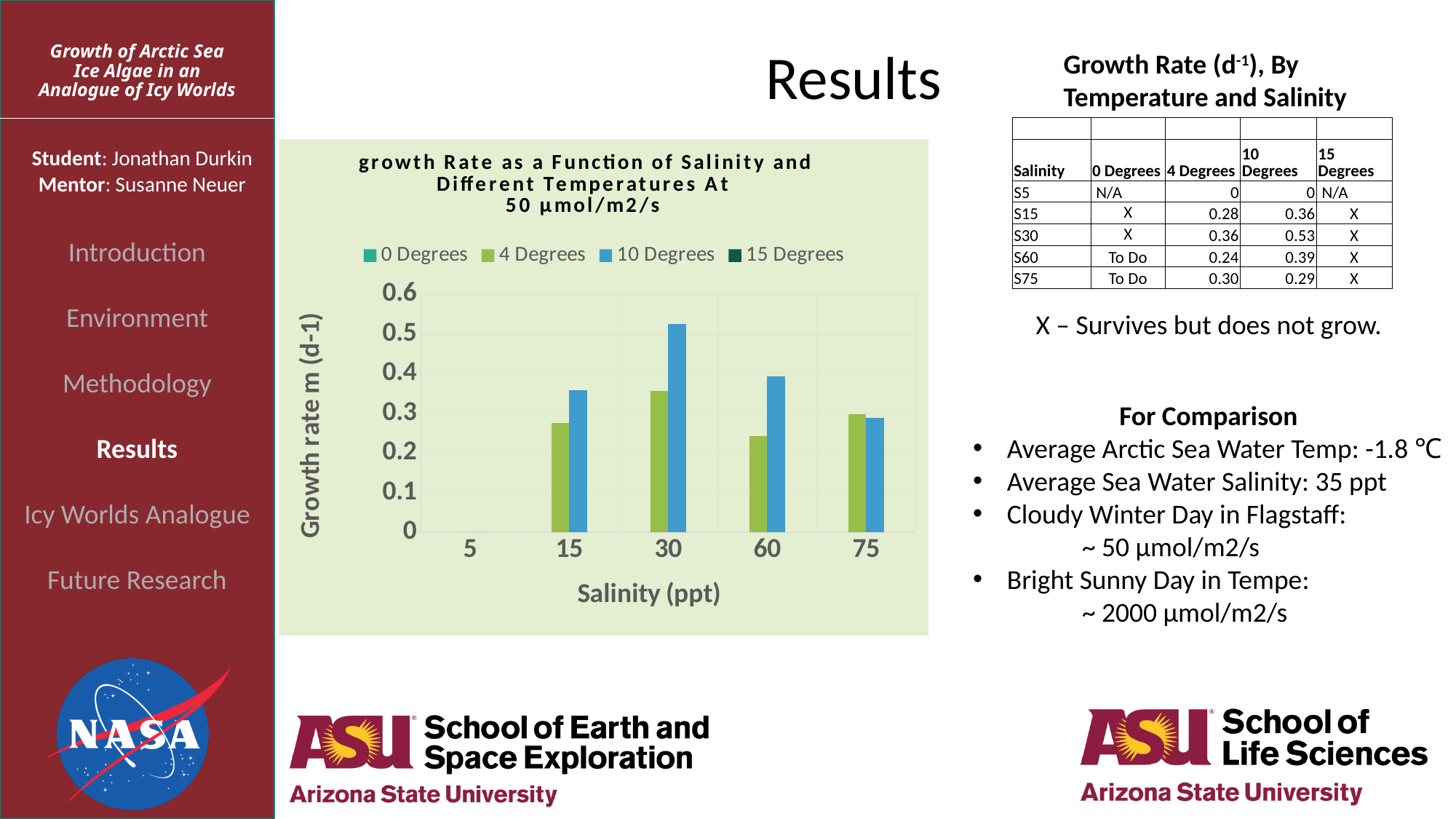
At which salinity is the 4 Degrees growth rate highest? 30 At salinity 15, which series has the larger growth rate, 4 Degrees or 10 Degrees? 10 Degrees What is the y-axis title of the chart? Growth rate m (d-1) Is the 10 Degrees growth rate at salinity 30 greater or less than 0.5? greater How many salinity categories are shown on the x axis of the chart? 5 Is the 4 Degrees growth rate at salinity 60 greater or less than 0.3? less What is the x-axis title of the chart? Salinity (ppt) At which salinity is the 10 Degrees growth rate highest? 30 Among the salinities with bars, at which salinity is the 10 Degrees growth rate lowest? 75 Does the 10 Degrees growth rate rise or fall from salinity 30 to salinity 75? fall What kind of chart is shown on the slide? bar chart How many series does the chart legend list? 4